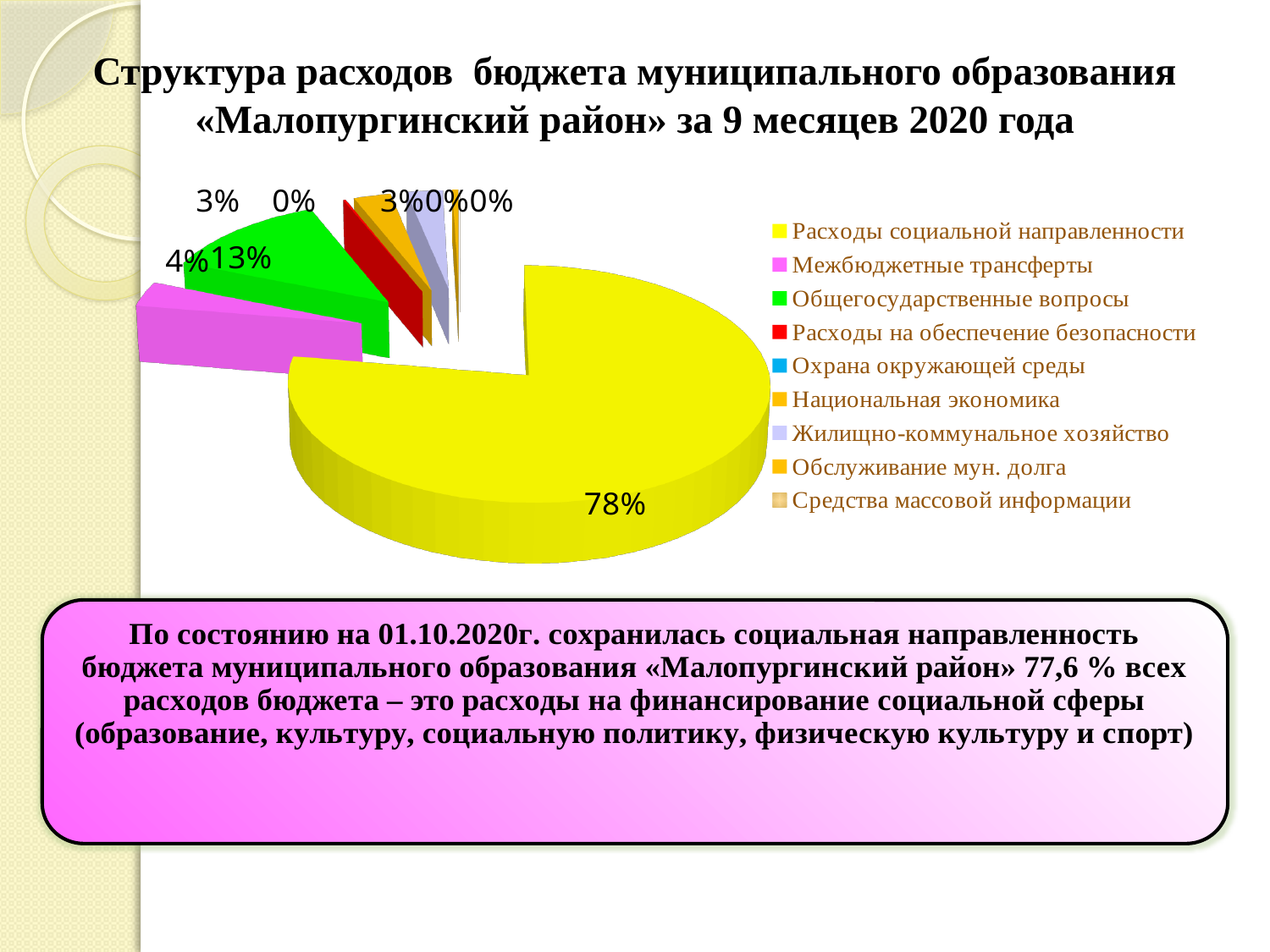
Is the share for Расходы социальной направленности greater or less than 50%? greater What colour is the slice for Расходы социальной направленности? Yellow What share of the pie is labelled for Расходы социальной направленности? 78% What is the difference in percentage points between Расходы социальной направленности and Общегосударственные вопросы? 65 percentage points Which is larger: Общегосударственные вопросы or Межбюджетные трансферты? Общегосударственные вопросы Which category has the largest share of the pie? Расходы социальной направленности How many categories does the legend list? 9 What percentage is shown for Общегосударственные вопросы? 13% What colour is the slice for Общегосударственные вопросы? Green What percentage is shown for Межбюджетные трансферты? 4% What type of chart is shown on the slide? Pie chart What is the difference in percentage points between Общегосударственные вопросы and Межбюджетные трансферты? 9 percentage points